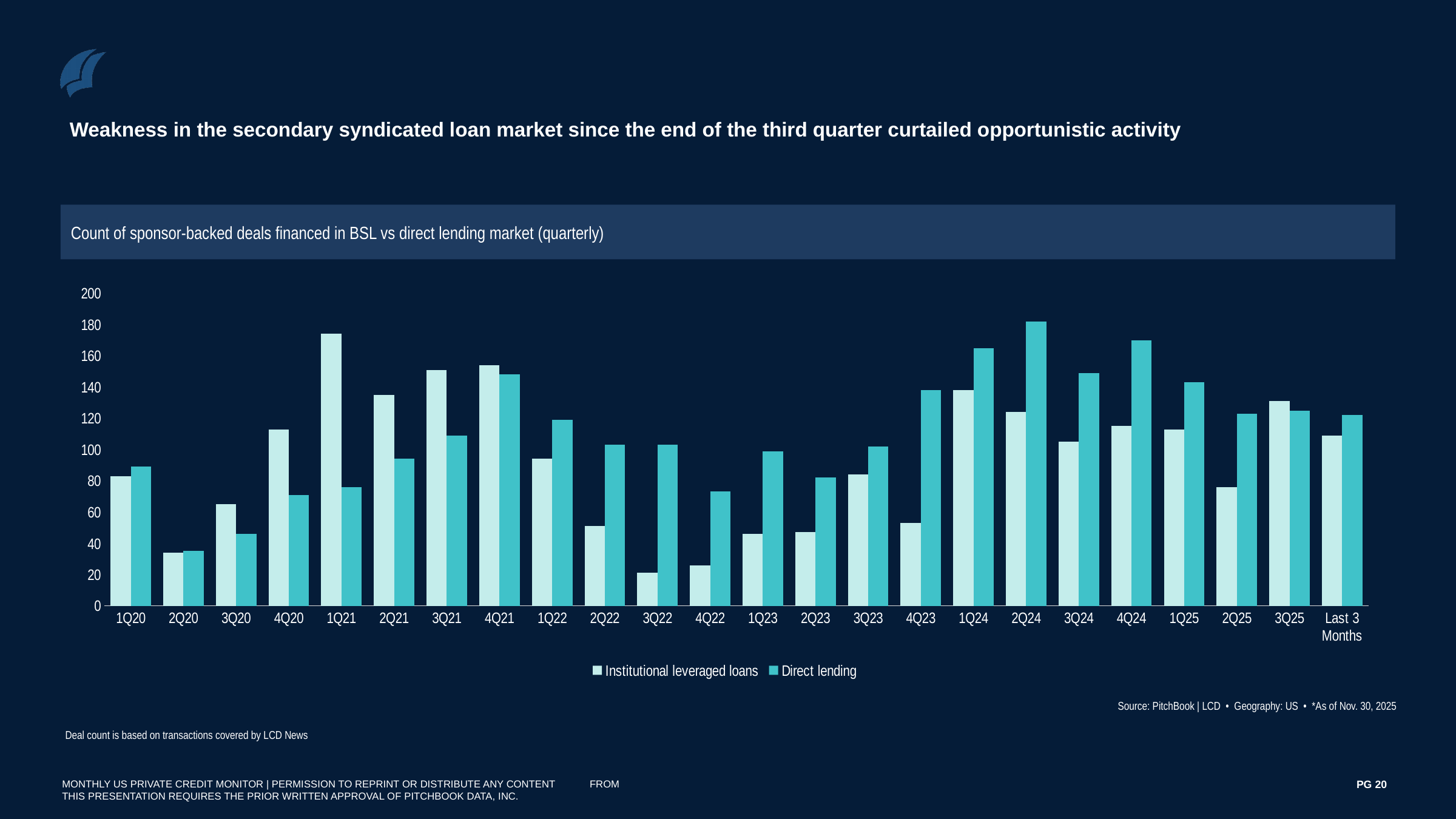
In which quarter is the Institutional leveraged loans value lowest? 3Q22 How many categories are shown on the x axis? 24 In which quarter is the Institutional leveraged loans value highest? 1Q21 Is the Direct lending value for 4Q24 greater or less than 160? greater In 1Q21, which series has the larger value: Institutional leveraged loans or Direct lending? Institutional leveraged loans In which quarter is the Direct lending value highest? 2Q24 How many series does the legend list? 2 What is the title of the chart? Count of sponsor-backed deals financed in BSL vs direct lending market (quarterly) Is the Institutional leveraged loans value for 4Q22 greater or less than 40? less What kind of chart is shown on the slide? Bar chart Is the Institutional leveraged loans value for 1Q21 greater or less than 160? greater In 3Q22, which series has the larger value: Institutional leveraged loans or Direct lending? Direct lending